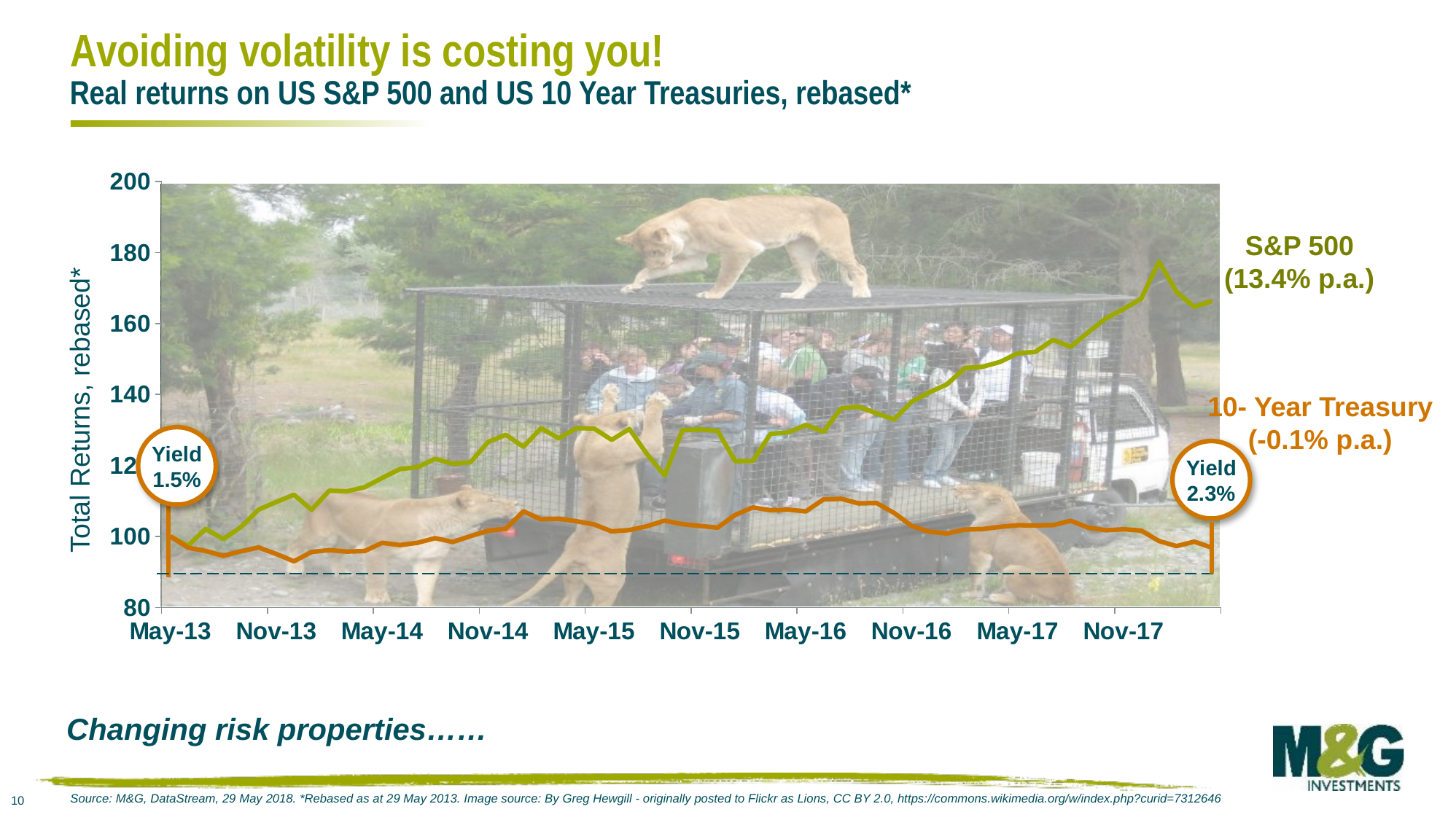
How many series are plotted on the chart? 2 Is the final value of the S&P 500 line greater or less than 160? greater What kind of chart is shown on the slide? line chart Does the S&P 500 line generally rise or fall from May-13 to the end of the chart? rise What yield is labelled at the start of the chart (May-13)? 1.5% What annualised return is shown for the 10-Year Treasury? -0.1% p.a. What yield is labelled at the end of the chart? 2.3% Is the final value of the 10-Year Treasury line greater or less than 100? less Which series ends higher at the right of the chart, S&P 500 or 10-Year Treasury? S&P 500 What is the label on the vertical axis? Total Returns, rebased* What is the first date shown on the horizontal axis? May-13 What annualised return is shown for the S&P 500? 13.4% p.a.